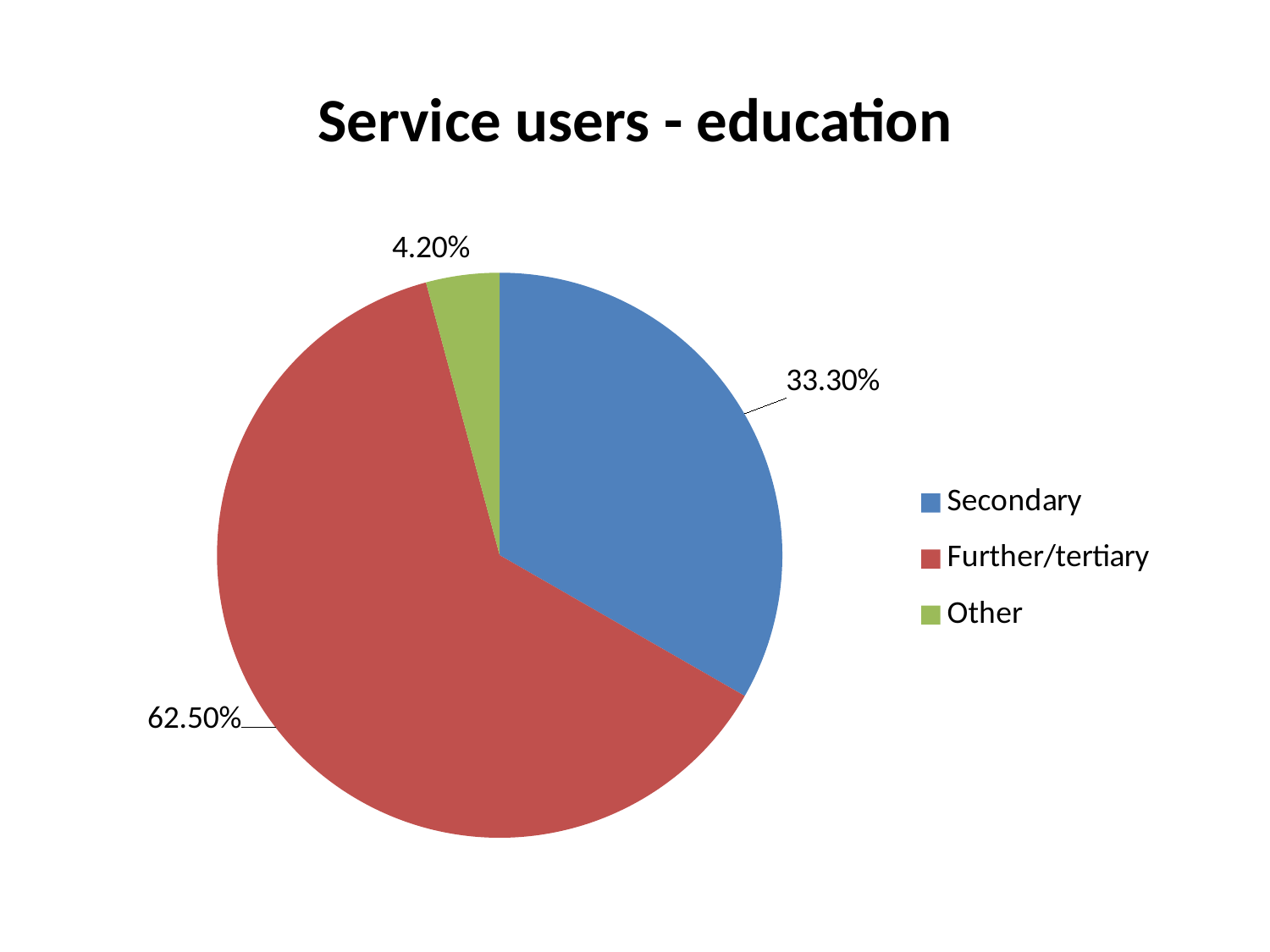
What share of service users have Secondary education? 33.30% Which education category has the largest share? Further/tertiary What kind of chart is shown on the slide? pie chart Which is larger, the Secondary share or the Other share? Secondary How many entries does the legend list? 3 What share of service users have Further/tertiary education? 62.50% Which education category has the smallest share? Other What is the difference between the Further/tertiary share and the Secondary share? 29.20% What is the title of the chart? Service users - education What colour is the Further/tertiary slice? red What share of service users fall into the Other category? 4.20% How many categories does the pie chart show? 3